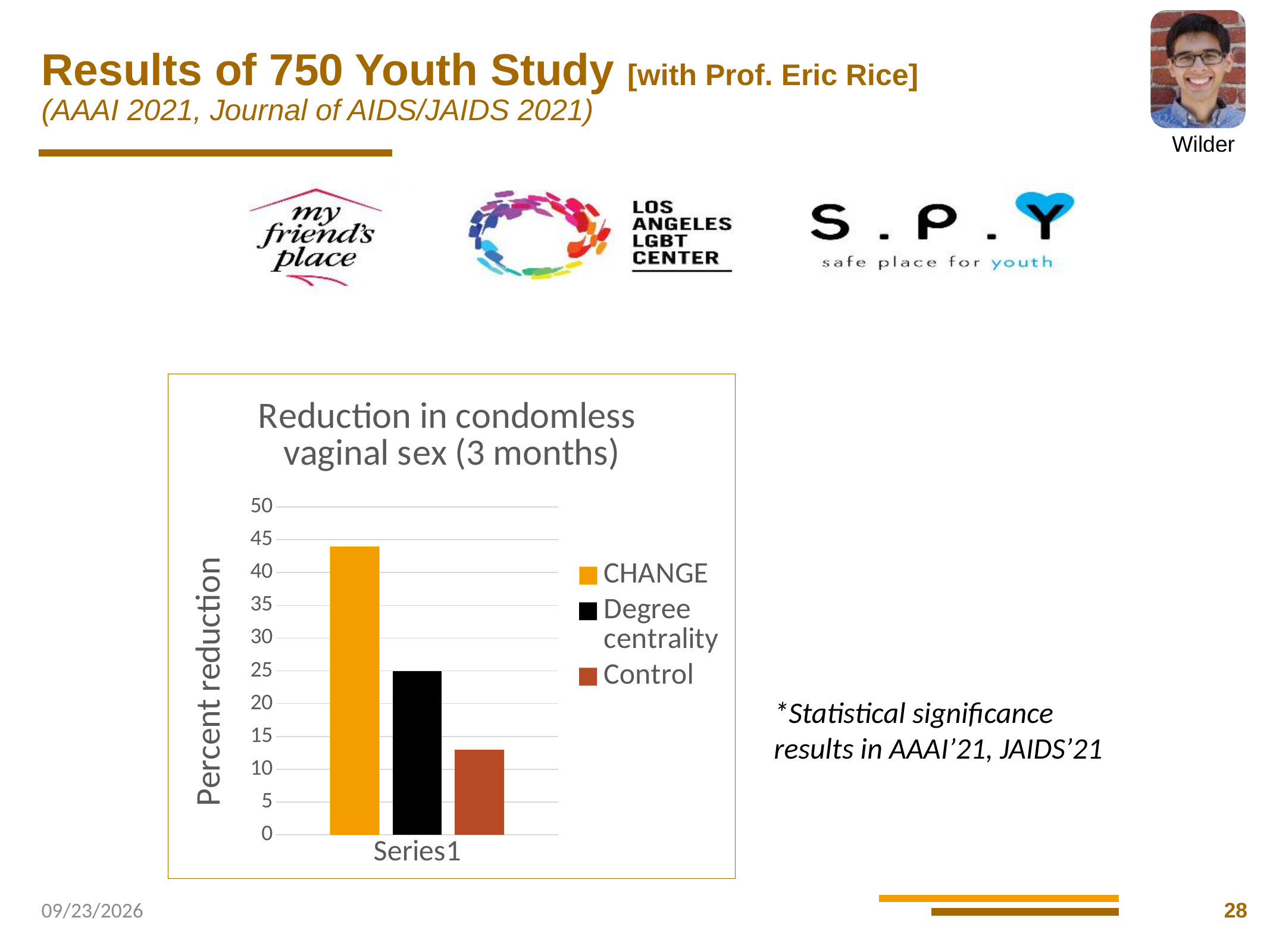
Which series has the highest percent reduction? CHANGE What is the label on the vertical axis of the chart? Percent reduction What is the title of the chart? Reduction in condomless vaginal sex (3 months) Is the percent reduction for Control greater or less than 10? greater Is the percent reduction for Control greater or less than 15? less Which series has the lowest percent reduction? Control How many series does the chart legend list? 3 Which has a larger percent reduction, Degree centrality or Control? Degree centrality What is the percent reduction for Degree centrality? 25 What kind of chart is shown on the slide? bar chart Which has a larger percent reduction, CHANGE or Degree centrality? CHANGE Is the percent reduction for CHANGE greater or less than 40? greater